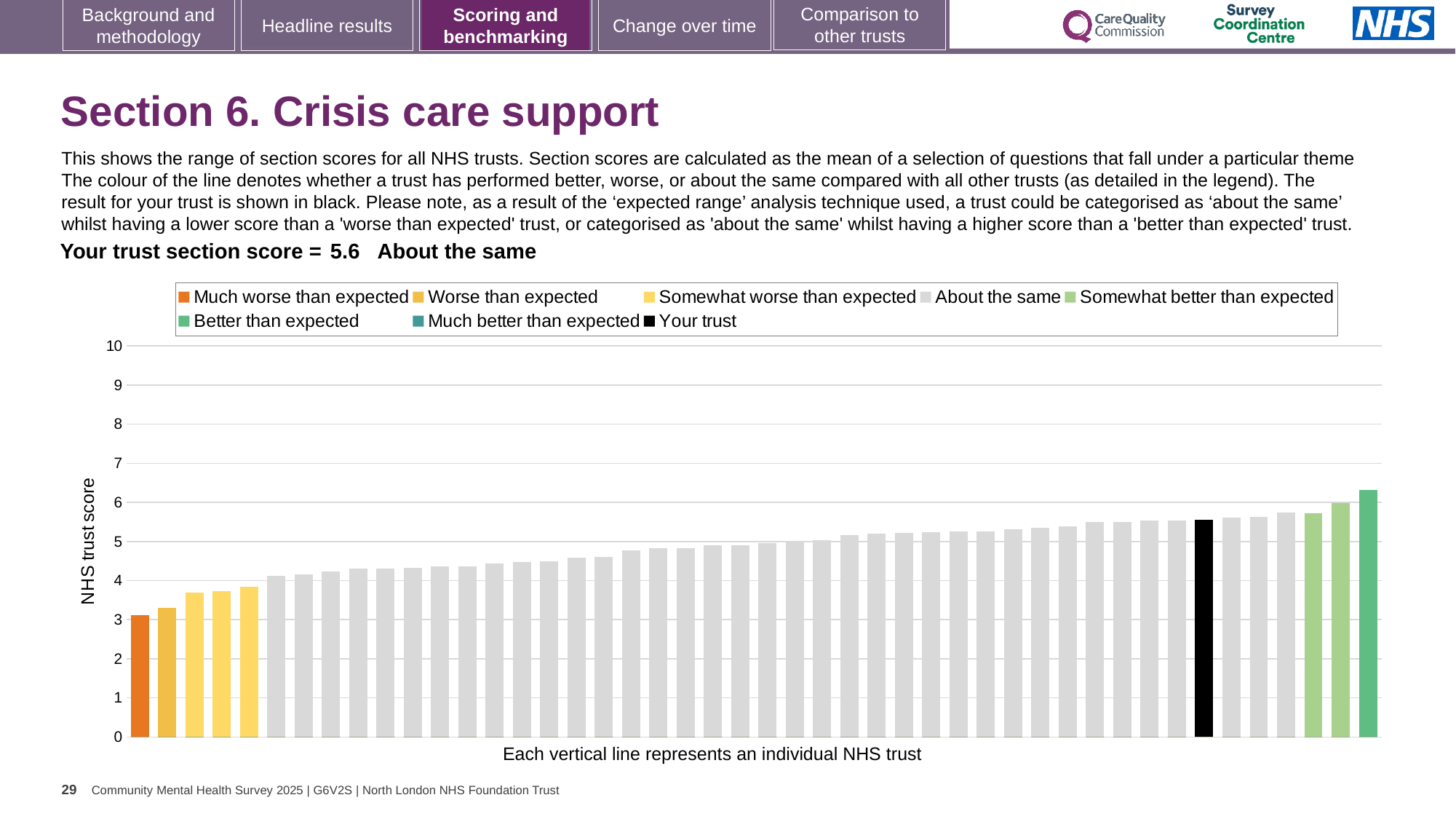
How many entries does the chart legend list? 8 Do the bar values rise or fall from left to right across the chart? rise What is the section score for your trust shown on the slide? 5.6 How many bars are coloured as 'Much worse than expected'? 1 Is the value of the highest bar in the chart greater or less than 7? less Which legend category does the tallest bar in the chart belong to? Better than expected Is the value of the black 'Your trust' bar greater or less than 5? greater Which category is your trust placed in for this section? About the same What kind of chart is shown on the slide? bar chart Is the value of the lowest bar (the 'Much worse than expected' trust) greater or less than 4? less How many bars are coloured as 'Somewhat better than expected'? 2 What is the label on the vertical axis of the chart? NHS trust score